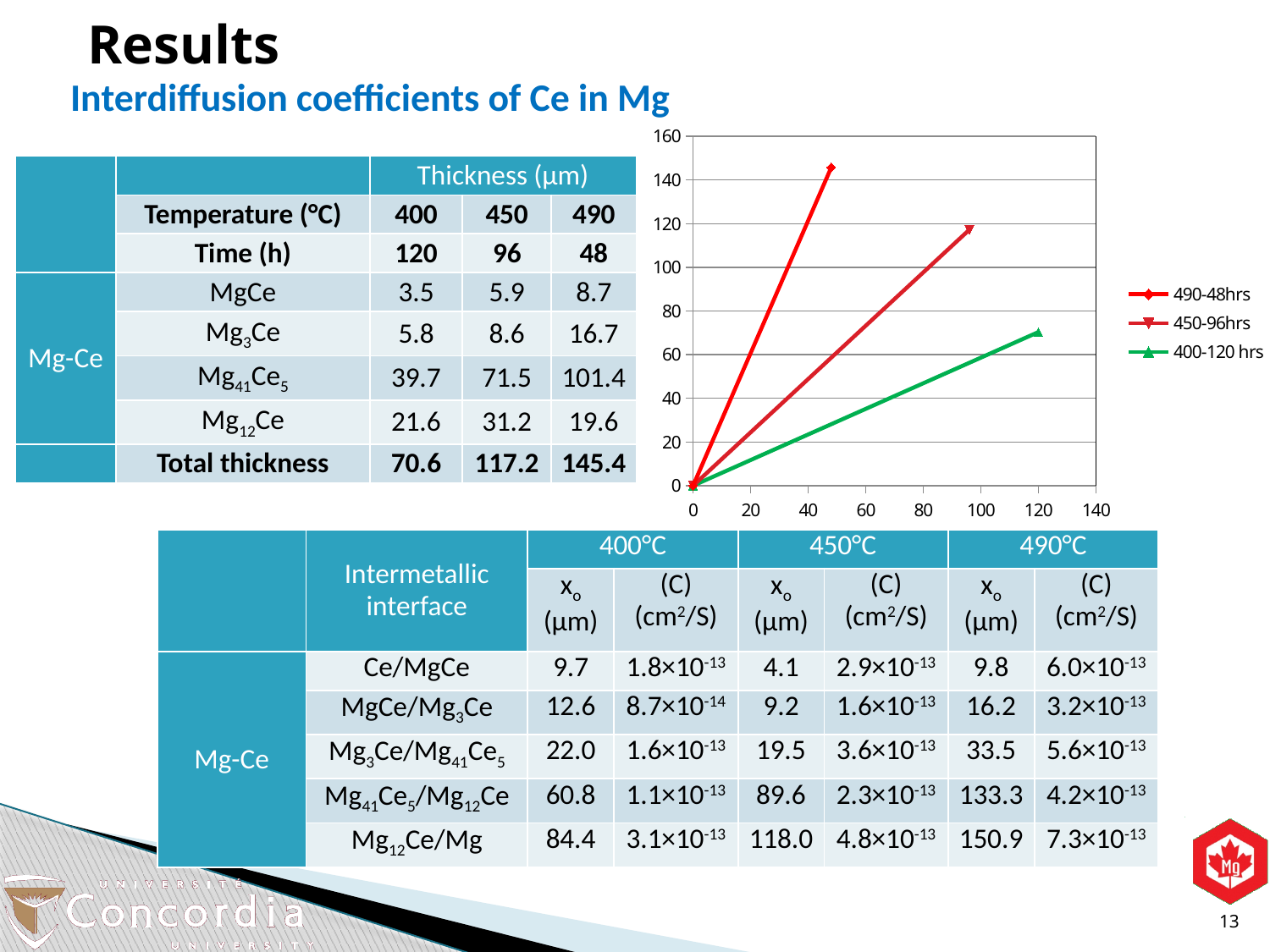
Which series in the chart reaches the highest value on the y axis? 490-48hrs How many series does the chart's legend list? 3 What are the three series names listed in the chart's legend? 490-48hrs, 450-96hrs, 400-120 hrs Do the values of each series rise or fall as x increases? rise Which series in the chart reaches the lowest maximum value on the y axis? 400-120 hrs At x = 40, which series has the higher value, 490-48hrs or 400-120 hrs? 490-48hrs Is the highest value reached by the 400-120 hrs series greater or less than 80? less Does the 400-120 hrs line end at an x value greater or less than 100? greater What colour is the 400-120 hrs line in the chart? green Is the highest value reached by the 490-48hrs series greater or less than 120? greater What kind of chart is shown on the slide? line chart